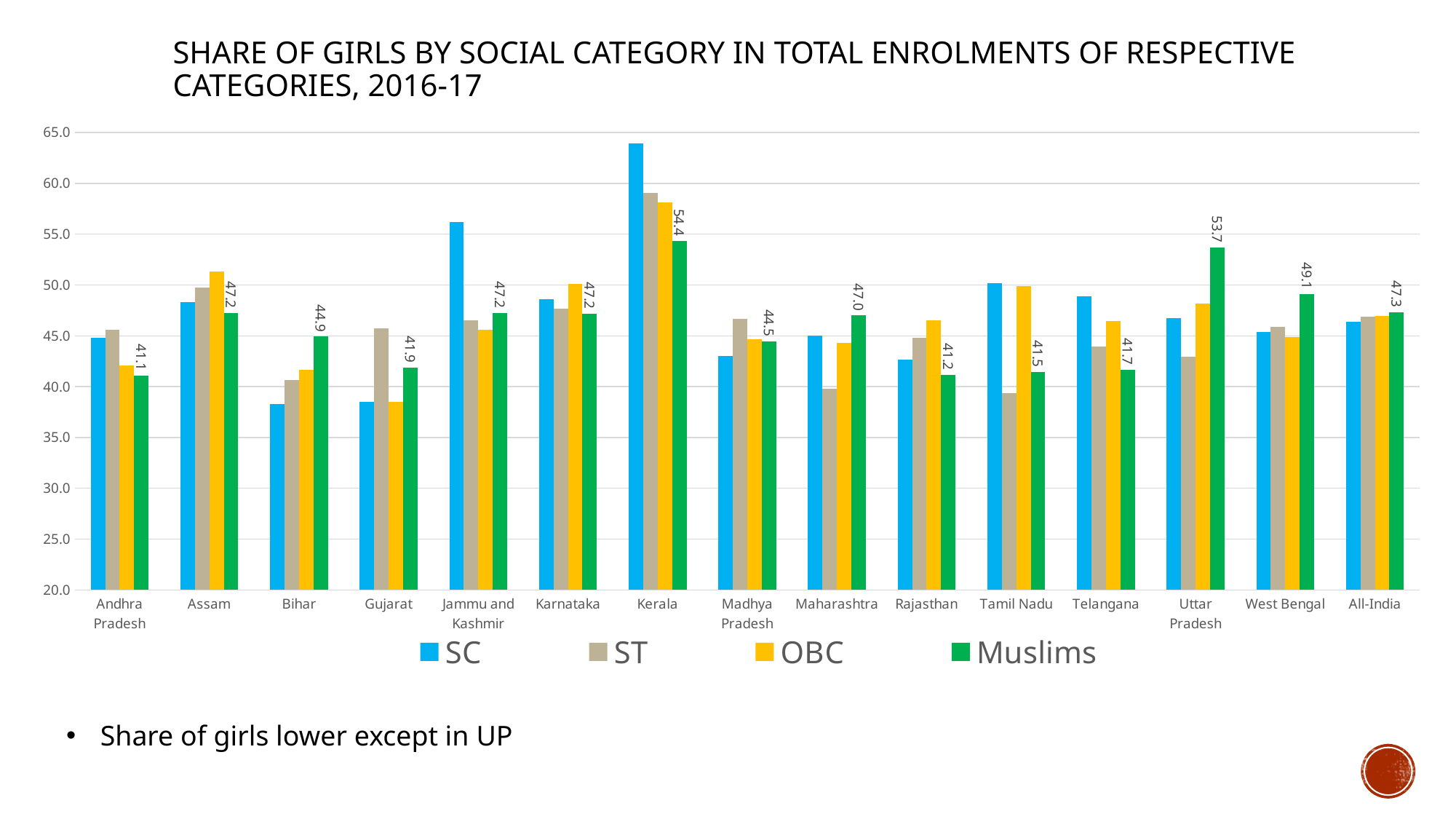
Which state has the lowest value for Muslims? Andhra Pradesh What is the All-India value for Muslims? 47.3 What is the value for Muslims in Uttar Pradesh? 53.7 How many series does the legend list? 4 What is the difference between the Muslims values for West Bengal and Andhra Pradesh? 8.0 What is the value for Muslims in Kerala? 54.4 Is the value for SC in Kerala greater or less than 60.0? greater Which state has the highest value for Muslims? Kerala Which is larger for Muslims: Bihar or Gujarat? Bihar How many categories are shown on the x axis? 15 What is the value for Muslims in Andhra Pradesh? 41.1 Is the value for SC in Bihar greater or less than 40.0? less